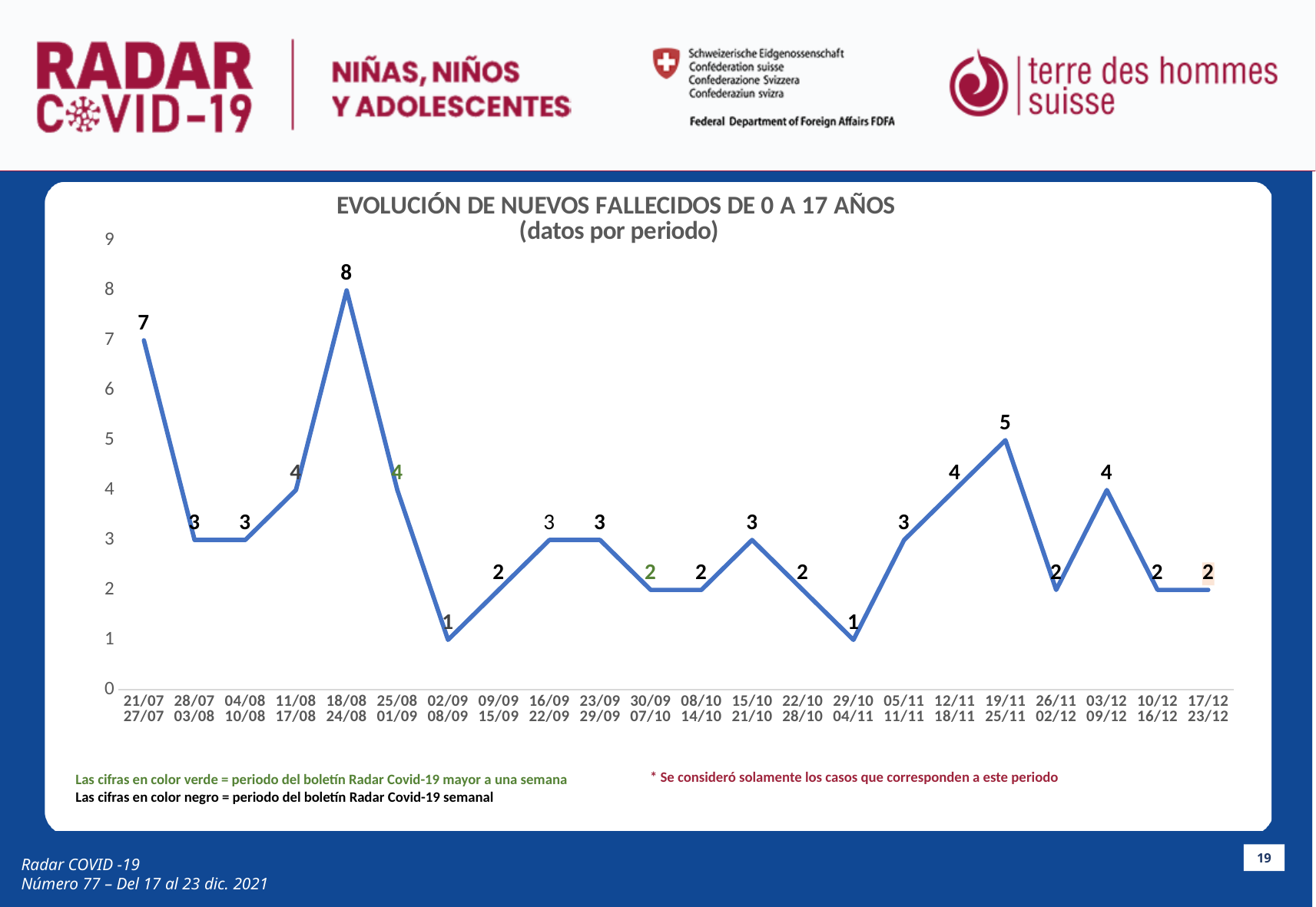
What is the value for the period 19/11–25/11? 5 What is the title of the chart? EVOLUCIÓN DE NUEVOS FALLECIDOS DE 0 A 17 AÑOS (datos por periodo) What is the value for the period 21/07–27/07? 7 Which is larger, the value for 12/11–18/11 or the value for 26/11–02/12? 12/11–18/11 What is the value for the last period, 17/12–23/12? 2 Which period has the highest value? 18/08–24/08 What type of chart is shown on the slide? line chart What is the value for the period 18/08–24/08? 8 How many periods (data points) are plotted on the chart? 22 What is the lowest value plotted on the chart? 1 What is the difference between the values for 18/08–24/08 and 25/08–01/09? 4 Does the value rise or fall from 19/11–25/11 to 26/11–02/12? fall